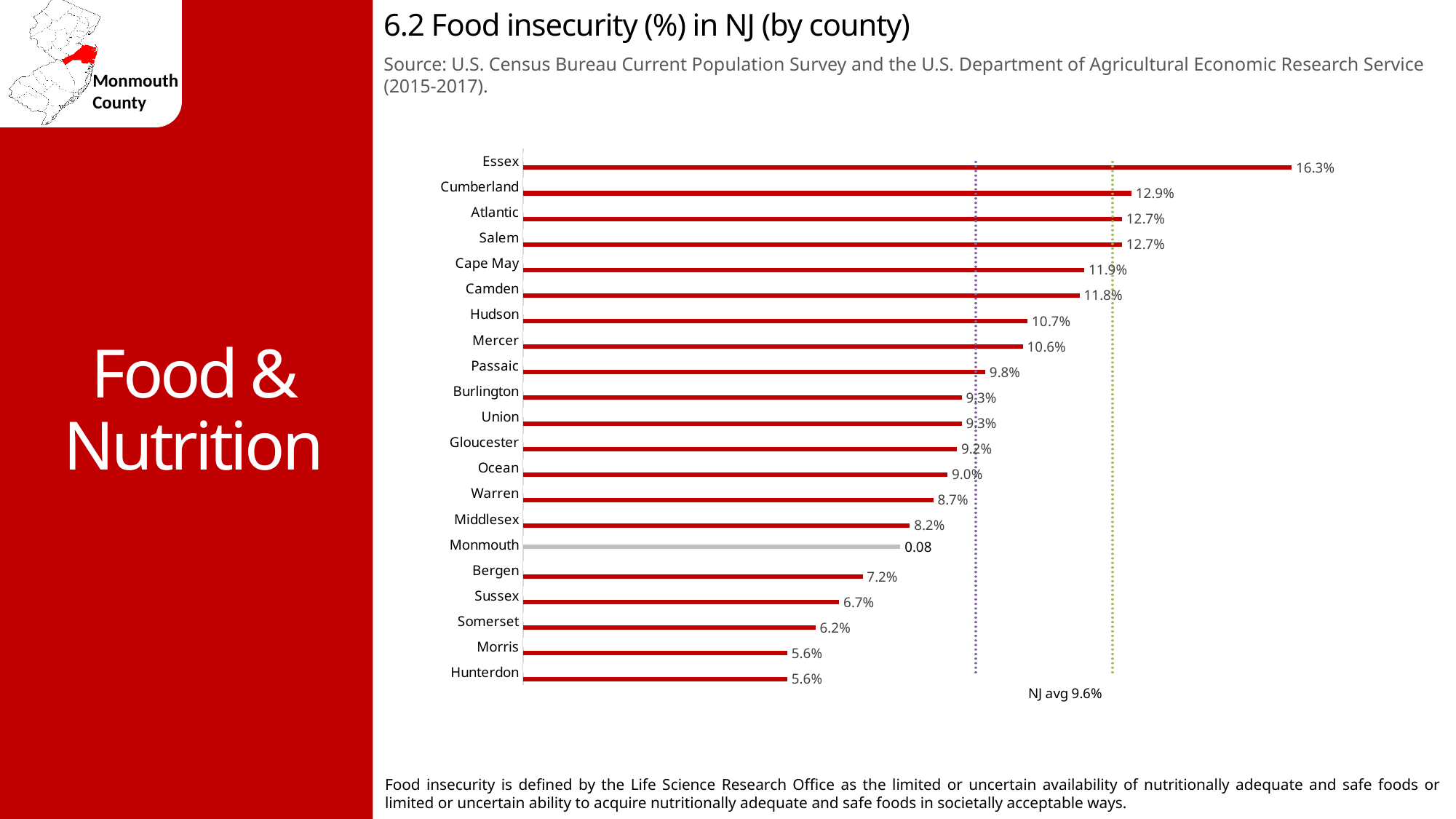
Which has a larger food insecurity value, Camden or Passaic? Camden What is the food insecurity value shown for Somerset? 6.2% What NJ average value is noted on the chart? 9.6% What is the food insecurity value shown for Hudson? 10.7% What is the difference between the values for Cape May and Bergen? 4.7 percentage points Which has a larger food insecurity value, Sussex or Warren? Warren How many counties are shown on the chart? 21 What is the difference between the values for Essex and Cumberland? 3.4 percentage points What kind of chart is shown on the slide? Bar chart What value is labeled for Monmouth on the chart? 0.08 What is the food insecurity value shown for Essex? 16.3% Which county has the highest food insecurity value on the chart? Essex